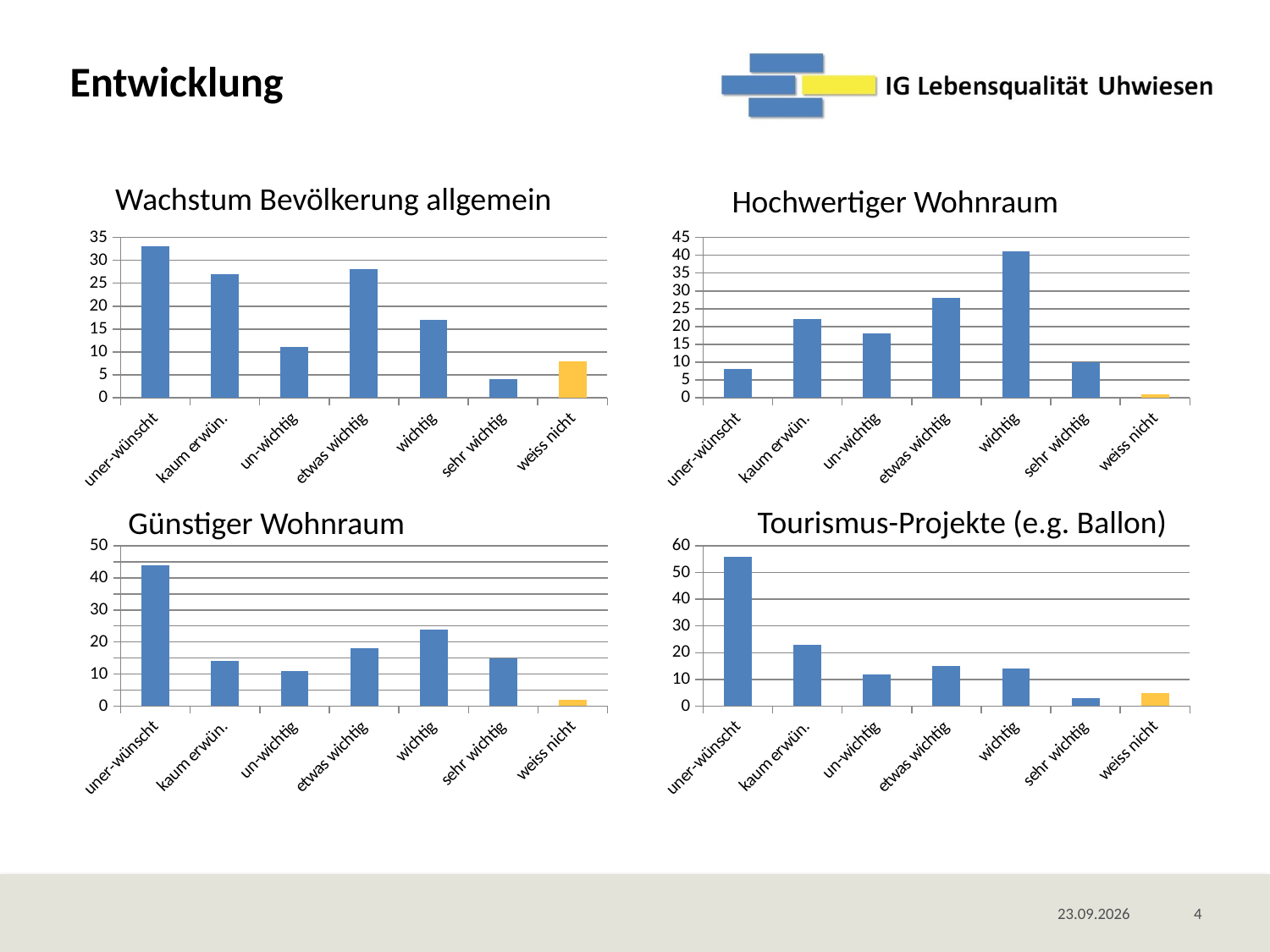
In the "Wachstum Bevölkerung allgemein" chart, which category has the highest value? uner-wünscht In the "Hochwertiger Wohnraum" chart, is the value for uner-wünscht greater or less than 10? less In the "Günstiger Wohnraum" chart, which category has the highest value? uner-wünscht In the "Hochwertiger Wohnraum" chart, which is larger, kaum erwün. or un-wichtig? kaum erwün. In the "Wachstum Bevölkerung allgemein" chart, which category has the lowest value? sehr wichtig In the "Wachstum Bevölkerung allgemein" chart, is the value for uner-wünscht greater or less than 30? greater In the "Tourismus-Projekte (e.g. Ballon)" chart, is the value for uner-wünscht greater or less than 50? greater In the "Tourismus-Projekte (e.g. Ballon)" chart, which category has the lowest value? sehr wichtig What kind of chart is "Wachstum Bevölkerung allgemein"? bar chart In the "Hochwertiger Wohnraum" chart, which category has the highest value? wichtig How many categories are shown on the x axis of the "Tourismus-Projekte (e.g. Ballon)" chart? 7